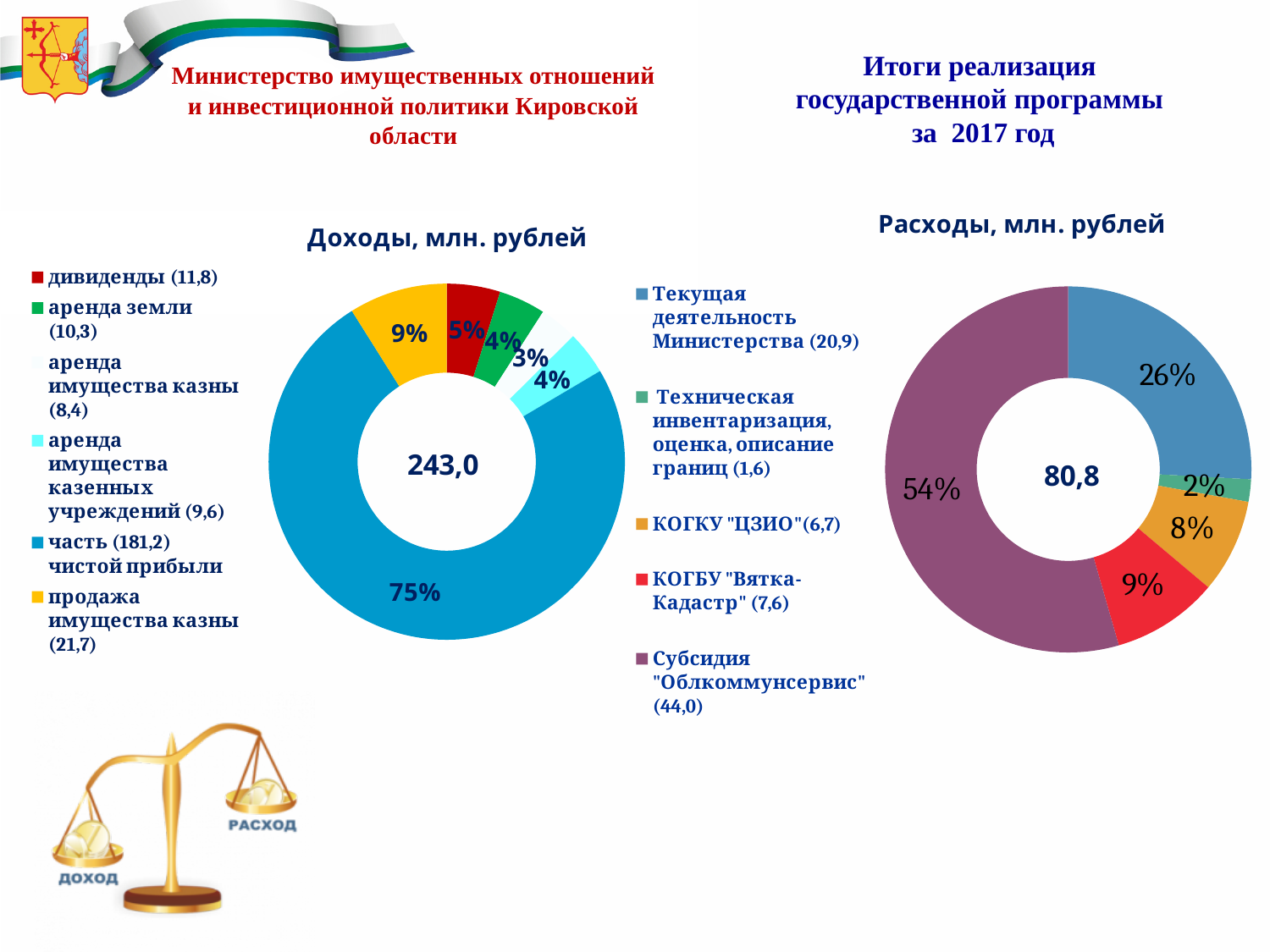
On the "Доходы, млн. рублей" chart, which category has the largest share? часть чистой прибыли On the "Доходы, млн. рублей" chart, how many categories does the legend list? 6 On the "Расходы, млн. рублей" chart, what value is given in the legend for "Текущая деятельность Министерства"? 20,9 On the "Расходы, млн. рублей" chart, what share of the pie is labelled for "Субсидия "Облкоммунсервис""? 54% On the "Доходы, млн. рублей" chart, what value is given in the legend for "продажа имущества казны"? 21,7 On the "Доходы, млн. рублей" chart, what share of the pie is labelled for "часть чистой прибыли"? 75% On the "Доходы, млн. рублей" chart, which category has the smallest share? аренда имущества казны On the "Доходы, млн. рублей" chart, what total is shown in the centre of the doughnut? 243,0 On the "Расходы, млн. рублей" chart, which is larger: the value for "КОГКУ "ЦЗИО"" or for "КОГБУ "Вятка-Кадастр""? КОГБУ "Вятка-Кадастр" What kind of chart is the "Расходы, млн. рублей" chart? doughnut (pie) chart On the "Доходы, млн. рублей" chart, what is the difference between the values for "дивиденды" and "аренда земли"? 1,5 On the "Расходы, млн. рублей" chart, which category has the smallest share? Техническая инвентаризация, оценка, описание границ